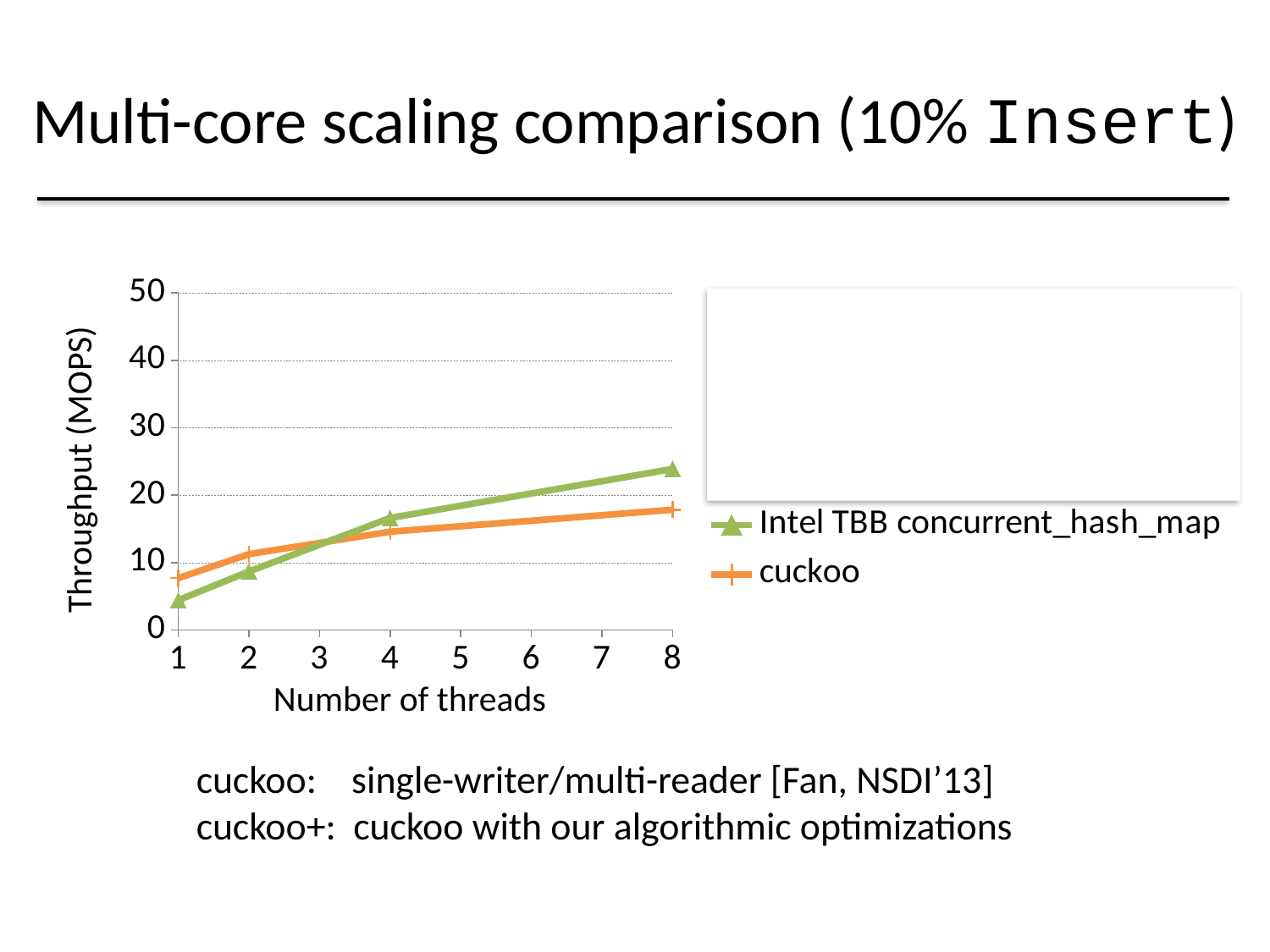
Is the throughput of cuckoo at 8 threads greater or less than 20? less Is the throughput of Intel TBB concurrent_hash_map at 1 thread greater or less than 10? less How many data points are plotted for the cuckoo series? 4 What is the label of the y axis? Throughput (MOPS) Does the throughput of Intel TBB concurrent_hash_map rise or fall as the number of threads increases? rise Is the throughput of Intel TBB concurrent_hash_map at 8 threads greater or less than 20? greater What kind of chart is shown on the slide? line chart How many series does the legend list? 2 At 8 threads, which series has the higher throughput, Intel TBB concurrent_hash_map or cuckoo? Intel TBB concurrent_hash_map At 1 thread, which series has the higher throughput, Intel TBB concurrent_hash_map or cuckoo? cuckoo What are the two series named in the legend? Intel TBB concurrent_hash_map and cuckoo